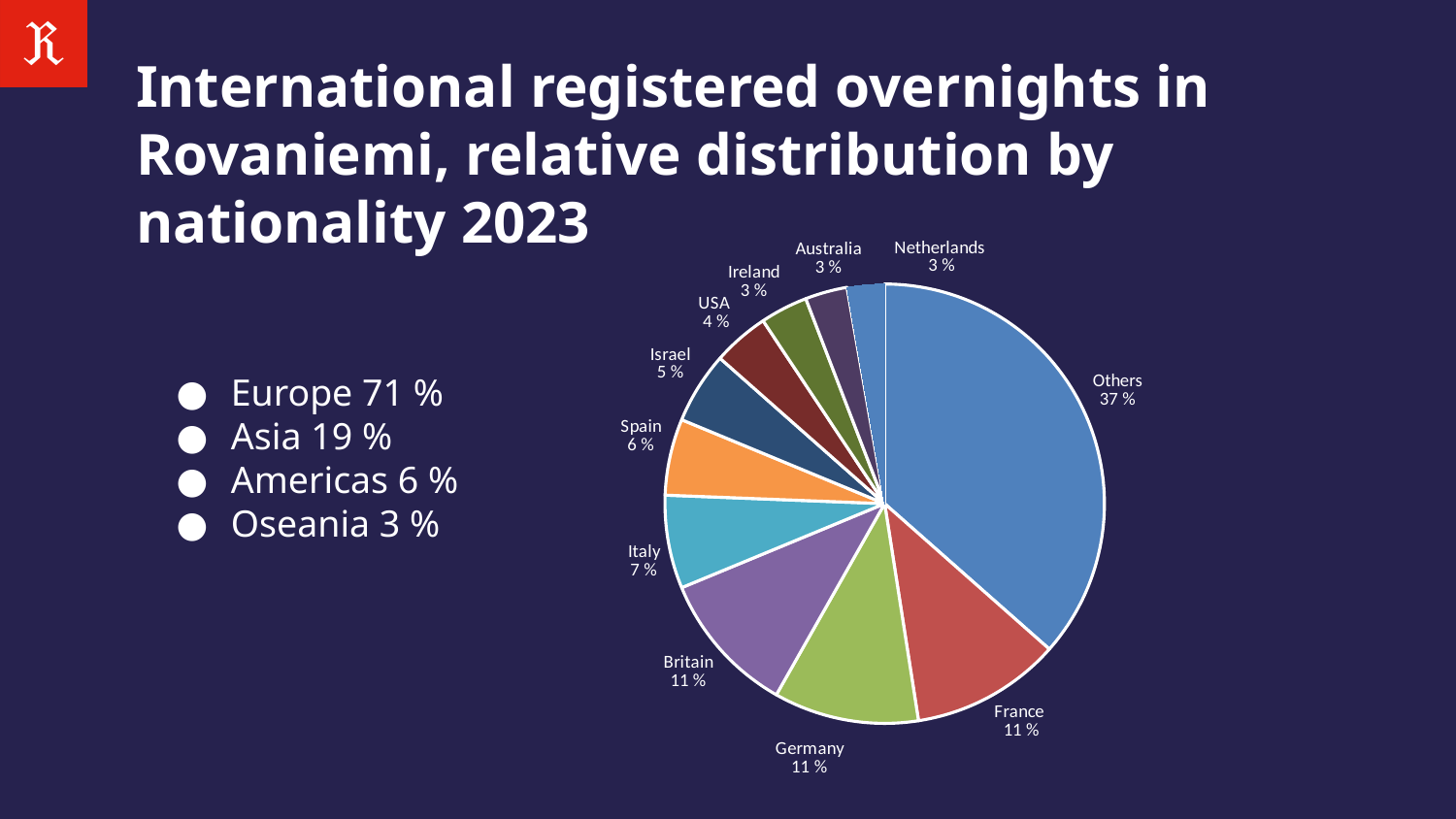
What is the value shown for USA? 4 % What is the difference between the Others slice and the France slice? 26 % What is the title of the slide containing the pie chart? International registered overnights in Rovaniemi, relative distribution by nationality 2023 What is the value shown for Israel? 5 % What kind of chart is shown on the slide? pie chart How many slices does the pie chart have? 11 Which is larger, the Britain slice or the Italy slice? Britain What is the difference between the Italy slice and the Spain slice? 1 % Which slice of the pie is the largest? Others Which is larger, the Spain slice or the Israel slice? Spain What is the value shown for Italy? 7 % What share of the pie does Germany account for? 11 %